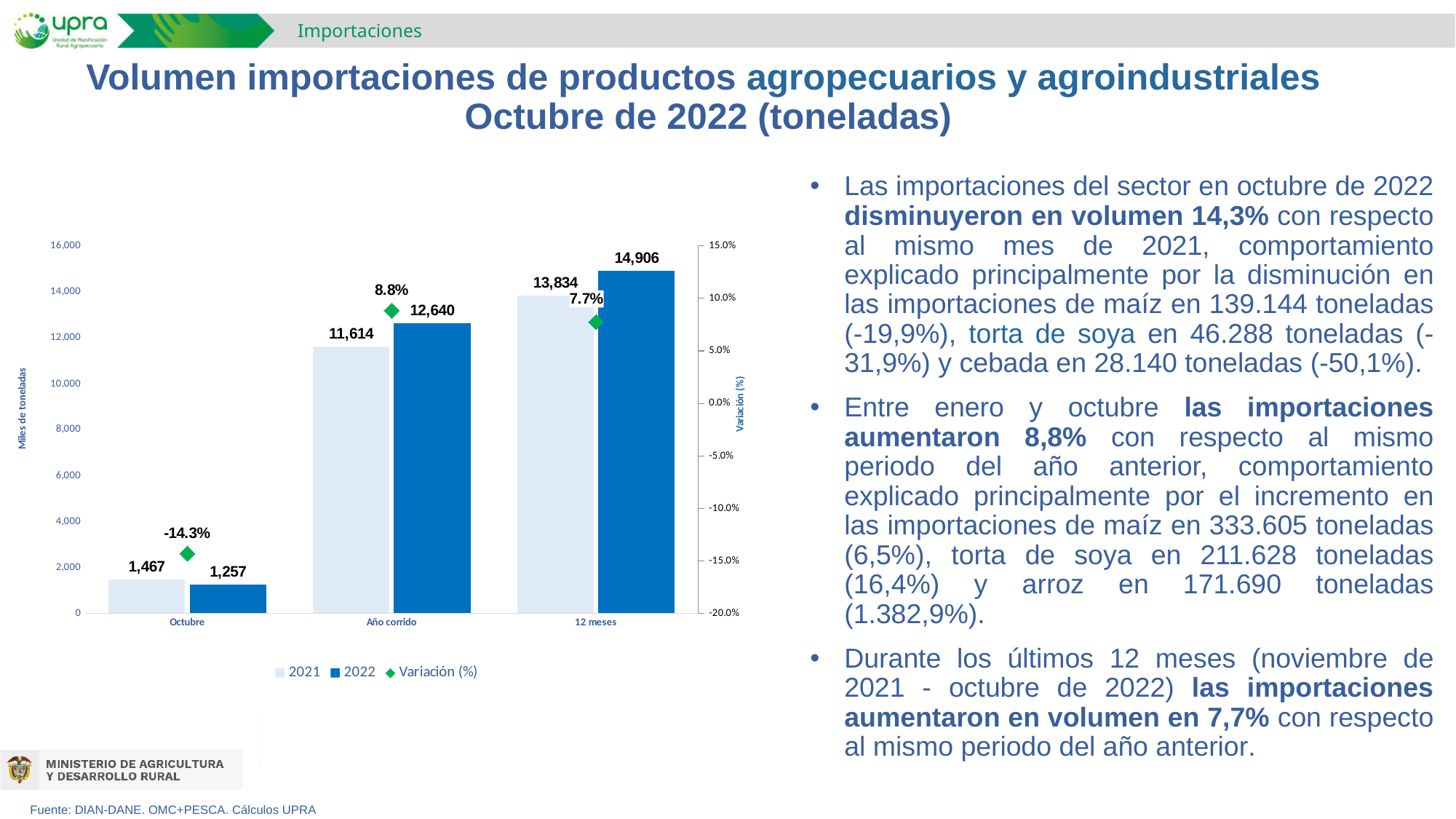
How many series does the legend list? 3 Which category has the lowest 2021 value? Octubre How many categories are shown on the x axis? 3 What kind of chart is shown on the slide? Bar chart with a line/marker series Which category has the highest 2022 value? 12 meses What is the 2021 value for Año corrido? 11,614 Which is larger for Octubre, the 2021 value or the 2022 value? 2021 What is the difference between the 2022 and 2021 values for 12 meses? 1,072 What is the Variación (%) value for 12 meses? 7.7% What is the Variación (%) value for Octubre? -14.3% What is the label of the left vertical axis? Miles de toneladas What is the 2022 value for Octubre? 1,257